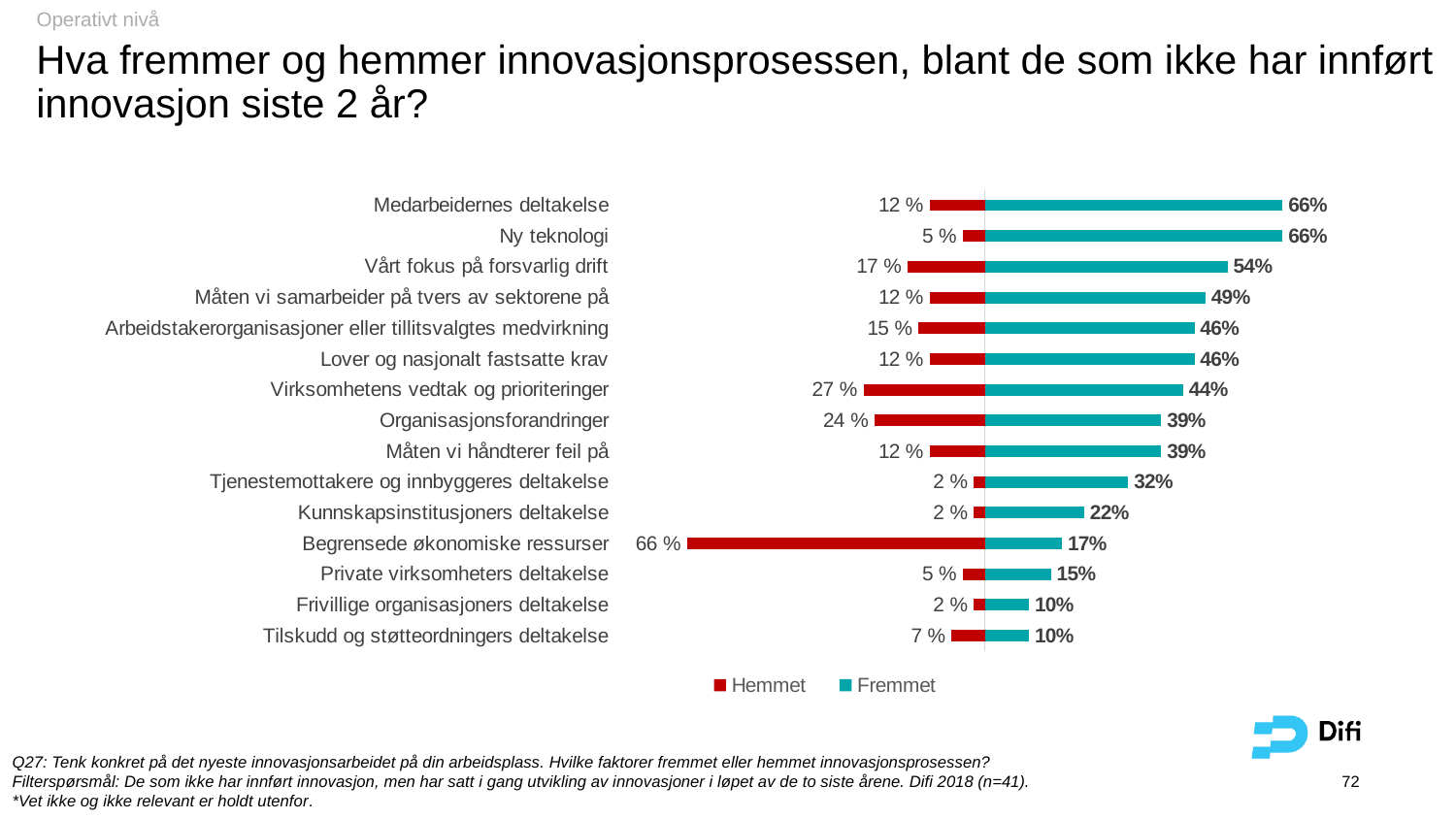
Which category has the highest Hemmet value? Begrensede økonomiske ressurser What is the Fremmet value for Medarbeidernes deltakelse? 66% What is the Hemmet value for Virksomhetens vedtak og prioriteringer? 27 % Which category has the lowest Fremmet value, apart from the tie with Tilskudd og støtteordningers deltakelse? Frivillige organisasjoners deltakelse What is the Fremmet value for Tjenestemottakere og innbyggeres deltakelse? 32% Which colour represents the Hemmet series in the chart? Red What is the difference between the Fremmet and Hemmet values for Vårt fokus på forsvarlig drift? 37 percentage points Which is larger for Organisasjonsforandringer, the Hemmet value or the Fremmet value? Fremmet How many series does the legend list? 2 How many categories are shown in the chart? 15 What is the Hemmet value for Begrensede økonomiske ressurser? 66 % What kind of chart is shown on the slide? Bar chart